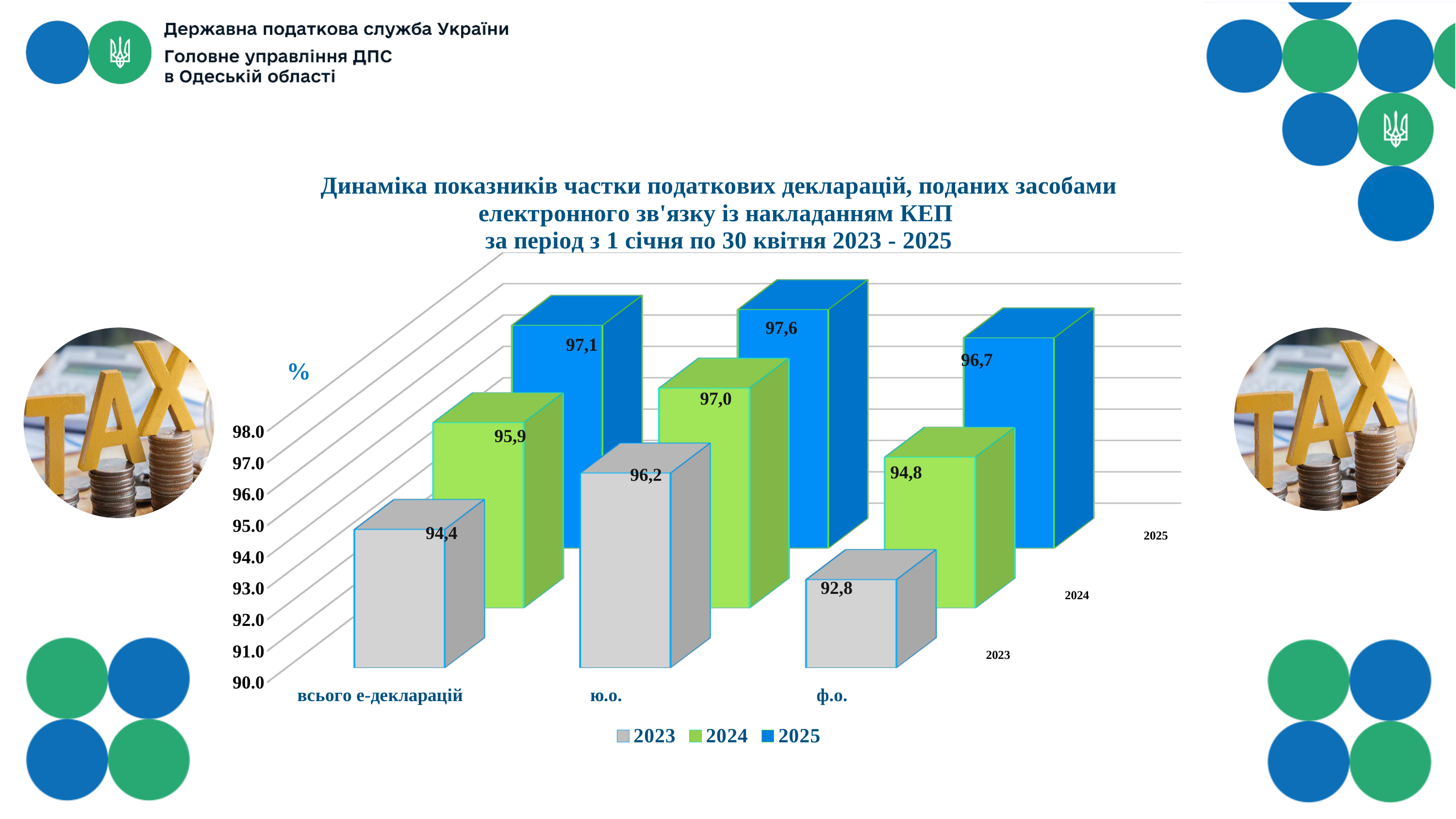
What is the value for "ф.о." in the 2023 series? 92,8 Which is larger: the 2024 value for "всього е-декларацій" or the 2024 value for "ю.о."? ю.о. How many categories are shown on the x axis? 3 How many series does the legend list? 3 Which category has the highest value in the 2025 series? ю.о. Do the values for "ю.о." rise or fall from 2023 to 2025? rise What is the value for "ю.о." in the 2025 series? 97,6 Which category has the lowest value in the 2023 series? ф.о. What is the value for "всього е-декларацій" in the 2023 series? 94,4 What is the difference between the 2025 and 2023 values for "ф.о."? 3,9 What kind of chart is shown on the slide? bar chart What is the value for "ф.о." in the 2024 series? 94,8